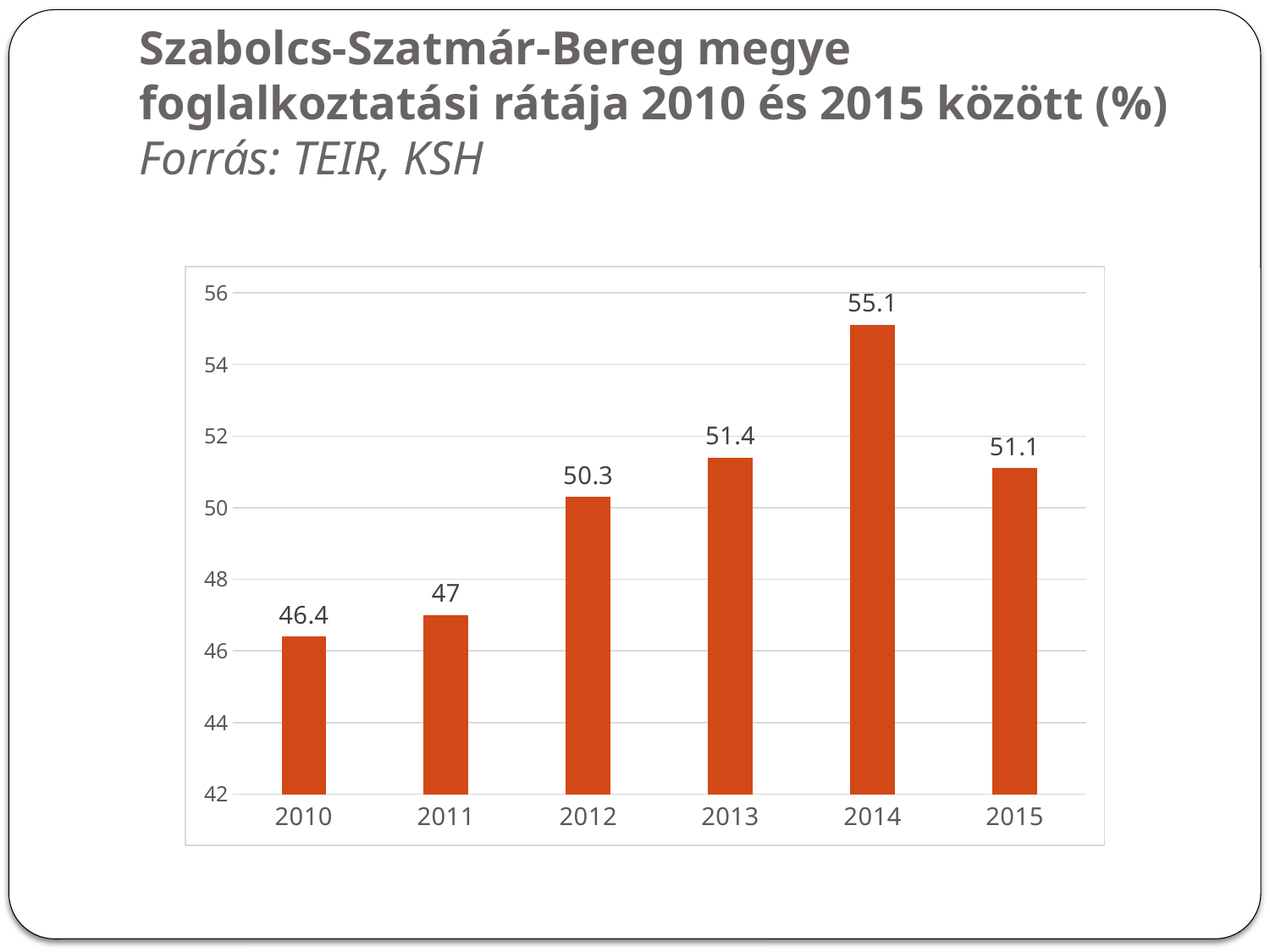
Which year has the highest value? 2014 How many years are shown on the x axis? 6 What kind of chart is shown on the slide? bar chart What is the difference between the values for 2014 and 2013? 3.7 What is the employment rate value shown for 2012? 50.3 According to the subtitle, what are the sources of the data? TEIR, KSH Is the value for 2012 greater or less than 50? greater What value is labelled on the bar for 2010? 46.4 What is the difference between the values for 2011 and 2010? 0.6 Which is larger, the value for 2013 or the value for 2015? 2013 Which year has the lowest value? 2010 What is the value for 2015? 51.1